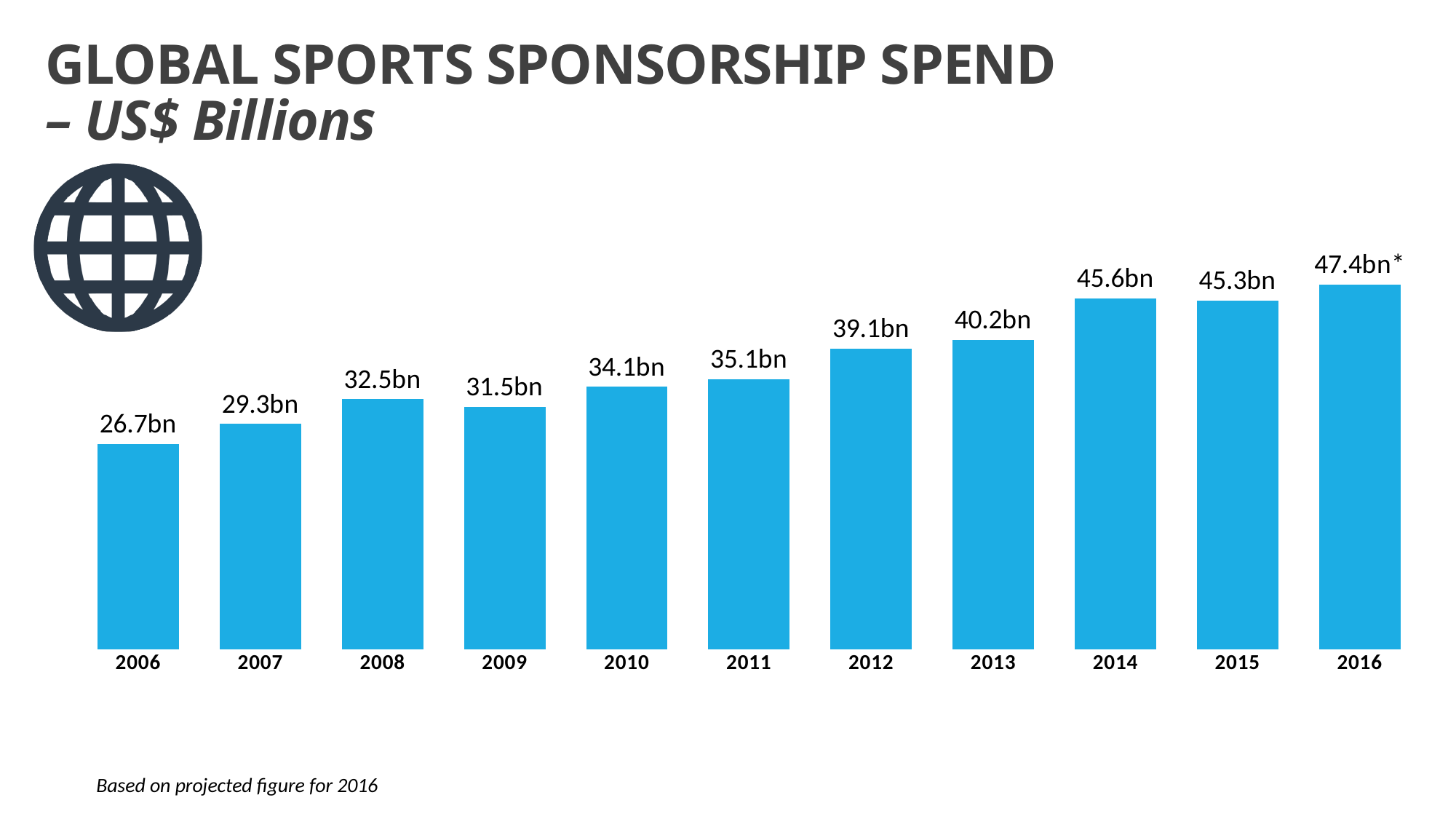
What kind of chart is shown on the slide? Bar chart How many years are shown on the chart? 11 Which year has the lowest sponsorship spend? 2006 What is the title of the chart? GLOBAL SPORTS SPONSORSHIP SPEND – US$ Billions What is the global sports sponsorship spend shown for 2010? 34.1bn What is the difference between the 2014 and 2015 values? 0.3bn Which year has the highest sponsorship spend? 2016 What value is labelled on the bar for 2013? 40.2bn By how much did spend increase from 2006 to 2007? 2.6bn Do the values generally rise or fall from 2006 to 2016? Rise Which is larger, the value for 2008 or the value for 2009? 2008 What is the projected spend shown for 2016? 47.4bn*